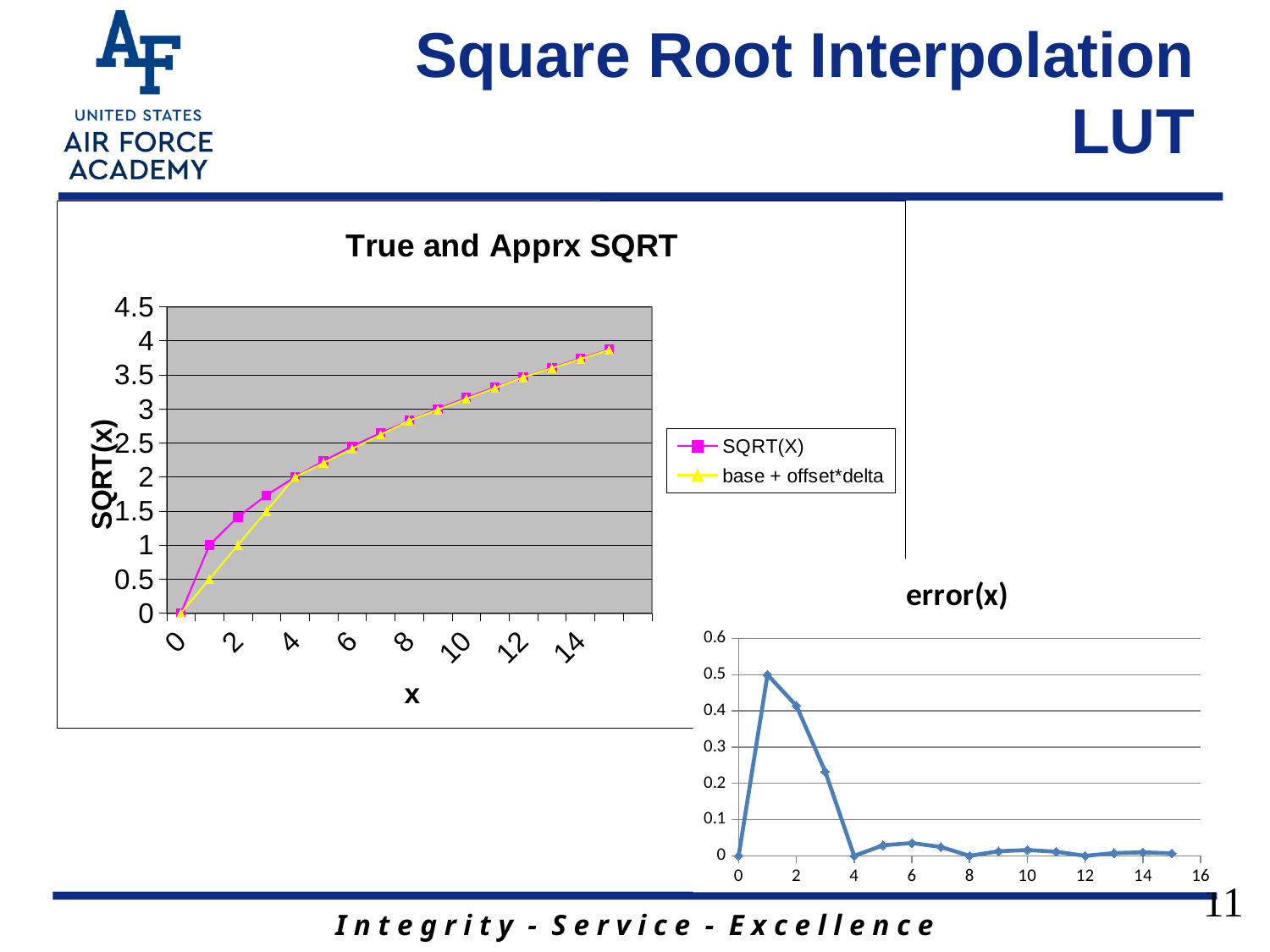
In the 'error(x)' chart, is the error value at x = 2 greater or less than 0.3? greater In the 'True and Apprx SQRT' chart, what is the SQRT(X) value at x = 1? 1 What kind of chart is the 'True and Apprx SQRT' chart? line chart In the 'error(x)' chart, which has the larger error: x = 1 or x = 3? x = 1 What kind of chart is the 'error(x)' chart? line chart In the 'True and Apprx SQRT' chart, what are the two legend entries? SQRT(X) and base + offset*delta In the 'error(x)' chart, what is the error value at x = 1? 0.5 In the 'True and Apprx SQRT' chart, what is the SQRT(X) value at x = 4? 2 How many series does the legend of the 'True and Apprx SQRT' chart list? 2 In the 'error(x)' chart, at which x value is the error highest? 1 In the 'True and Apprx SQRT' chart, do the SQRT(X) values rise or fall as x increases? rise In the 'True and Apprx SQRT' chart, is the SQRT(X) value at x = 9 greater or less than 2.5? greater